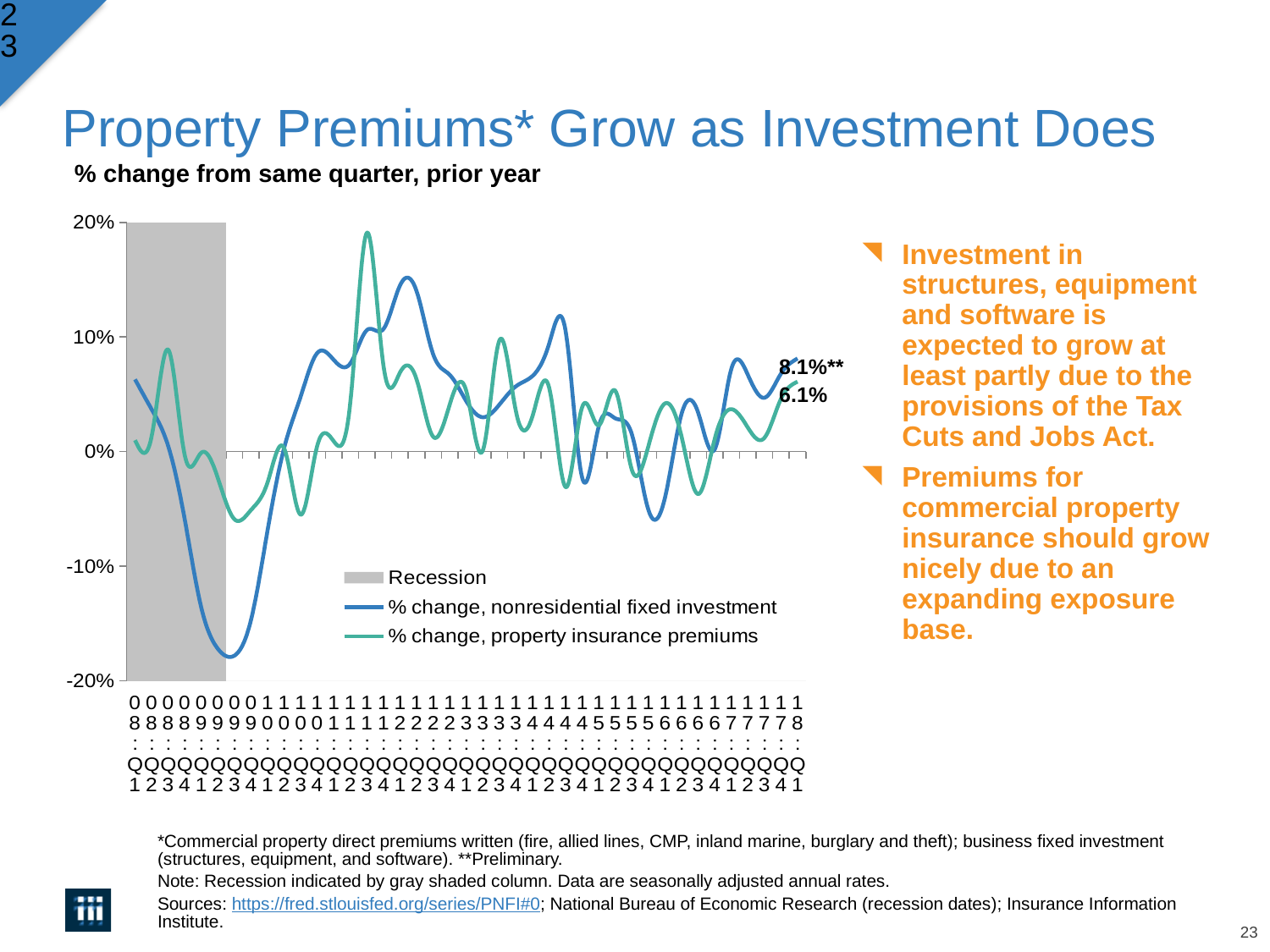
What does the gray shaded column on the chart indicate? Recession What is the title of the chart on the slide? Property Premiums* Grow as Investment Does Is the lowest value of the nonresidential fixed investment line greater or less than -10%? less What type of chart is shown on the slide? Line chart Which series reaches the highest peak on the chart? % change, property insurance premiums What is the difference between the final labeled values of the two series (8.1% and 6.1%)? 2.0 percentage points Which series reaches the lowest value on the chart? % change, nonresidential fixed investment What is the latest value shown for % change, property insurance premiums? 6.1% What is the latest (preliminary) value shown for % change, nonresidential fixed investment? 8.1% At the final data point, which series has the larger value: nonresidential fixed investment or property insurance premiums? Nonresidential fixed investment Is the highest peak of the property insurance premiums line greater or less than 10%? greater How many entries does the chart legend list? 3